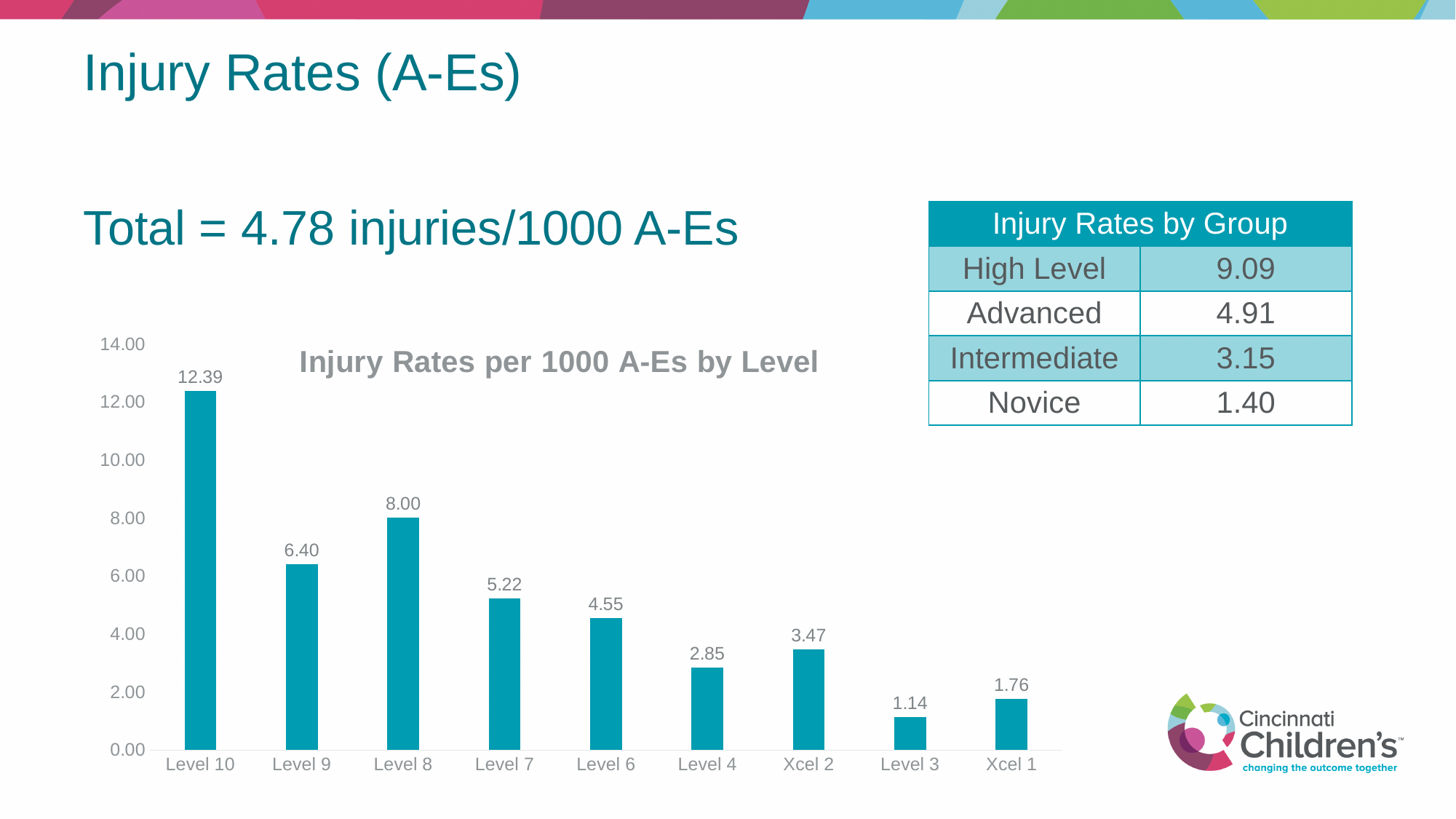
What is the injury rate per 1000 A-Es for Xcel 2? 3.47 Which level has the lowest injury rate per 1000 A-Es? Level 3 What is the title of the chart? Injury Rates per 1000 A-Es by Level What kind of chart is used to show injury rates by level? Bar chart What is the injury rate per 1000 A-Es for Level 7? 5.22 What is the difference between the injury rates for Level 8 and Level 9? 1.60 Which has a higher injury rate, Level 6 or Level 4? Level 6 Which level has the highest injury rate per 1000 A-Es? Level 10 How many levels are shown on the x axis of the chart? 9 What is the difference between the injury rates for Xcel 1 and Level 3? 0.62 What is the injury rate per 1000 A-Es for Level 10? 12.39 Is the injury rate for Level 9 greater or less than 6.00? greater